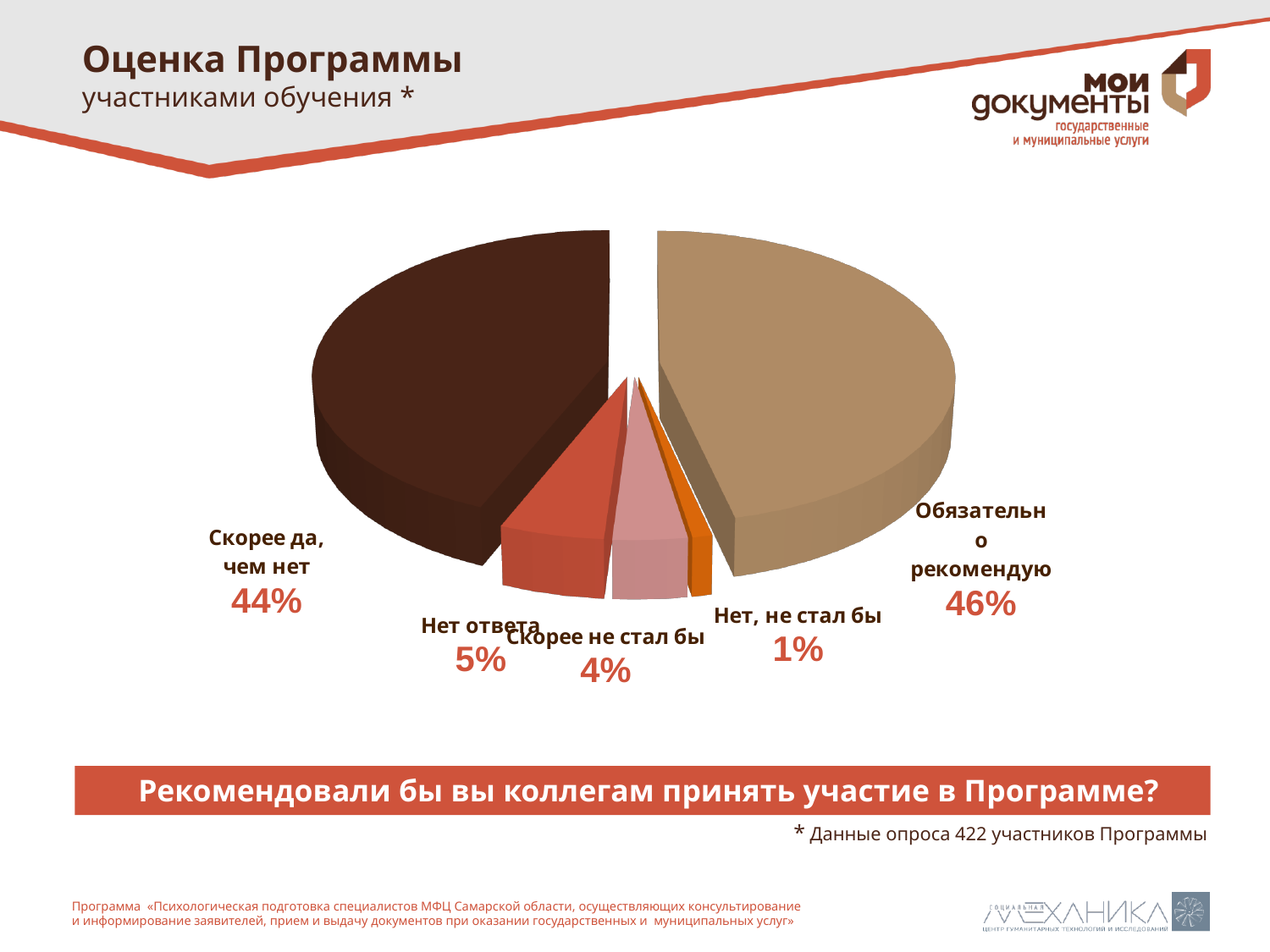
Which response has the largest share of the pie? Обязательно рекомендую What share of respondents answered "Скорее не стал бы"? 4% What share of respondents answered "Обязательно рекомендую"? 46% What is the difference in percentage points between "Обязательно рекомендую" and "Скорее да, чем нет"? 2 percentage points What type of chart is shown on the slide? Pie chart What share of respondents gave no answer ("Нет ответа")? 5% Which is larger: the share for "Нет ответа" or the share for "Скорее не стал бы"? Нет ответа What share of respondents answered "Нет, не стал бы"? 1% Which response has the smallest share of the pie? Нет, не стал бы What share of respondents answered "Скорее да, чем нет"? 44% How many response categories are shown in the pie chart? 5 How many participants were surveyed according to the footnote? 422